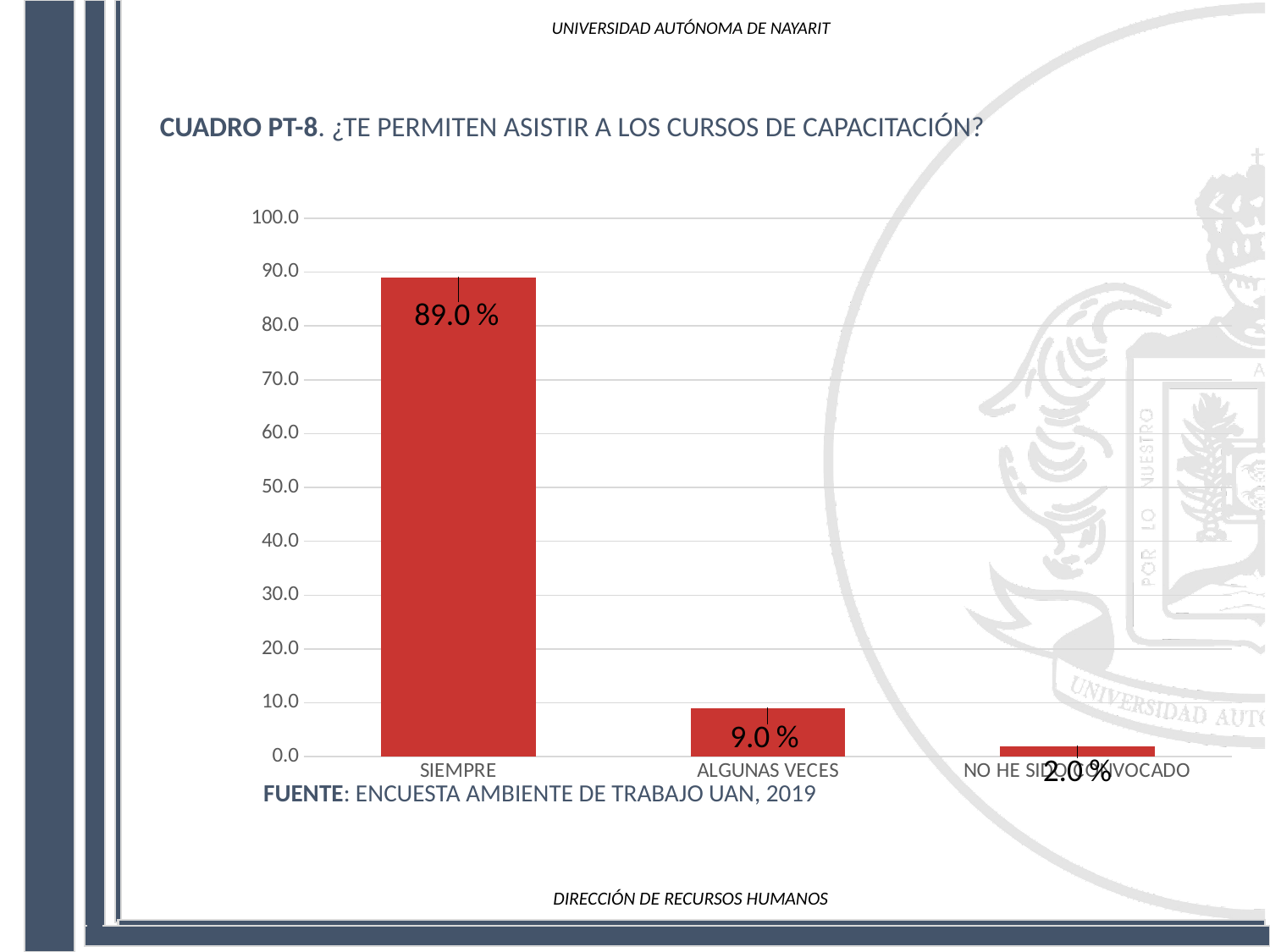
What is the value for SIEMPRE? 89.0 % What kind of chart is shown on the slide? bar chart What is the source cited below the chart? ENCUESTA AMBIENTE DE TRABAJO UAN, 2019 How many categories are shown on the x axis? 3 Is the value for SIEMPRE greater or less than 80.0? greater What is the difference between the values for SIEMPRE and ALGUNAS VECES? 80.0 % What is the value for NO HE SIDO CONVOCADO? 2.0 % Which category has the highest value? SIEMPRE Which category has the lowest value? NO HE SIDO CONVOCADO What is the difference between the values for ALGUNAS VECES and NO HE SIDO CONVOCADO? 7.0 % What is the value for ALGUNAS VECES? 9.0 % Which is larger, the value for ALGUNAS VECES or the value for NO HE SIDO CONVOCADO? ALGUNAS VECES